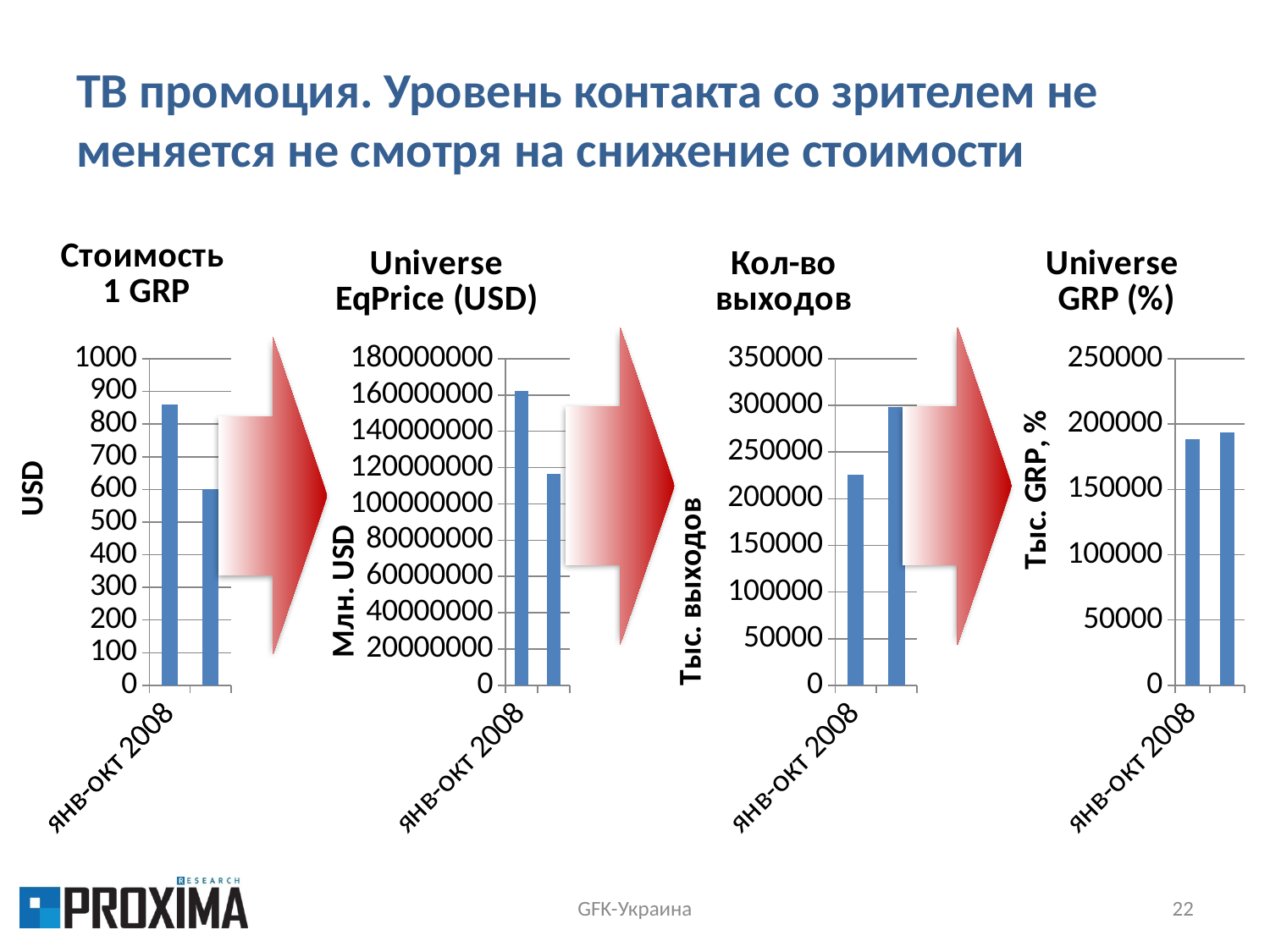
What is the y-axis title of the 'Кол-во выходов' chart? Тыс. выходов In the 'Universe EqPrice (USD)' chart, is the value of the left bar greater or less than 140000000? greater In the 'Кол-во выходов' chart, which bar is taller, the left one or the right one? the right one In the 'Universe GRP (%)' chart, is the value of the left bar greater or less than 200000? less In the 'Стоимость 1 GRP' chart, is the value of the right bar greater or less than 700? less Do the values in the 'Стоимость 1 GRP' chart rise or fall from the left bar to the right bar? fall In the 'Стоимость 1 GRP' chart, which bar is taller, the left one or the right one? the left one How many bars are plotted in the 'Кол-во выходов' chart? 2 What kind of chart is the 'Стоимость 1 GRP' chart? bar chart